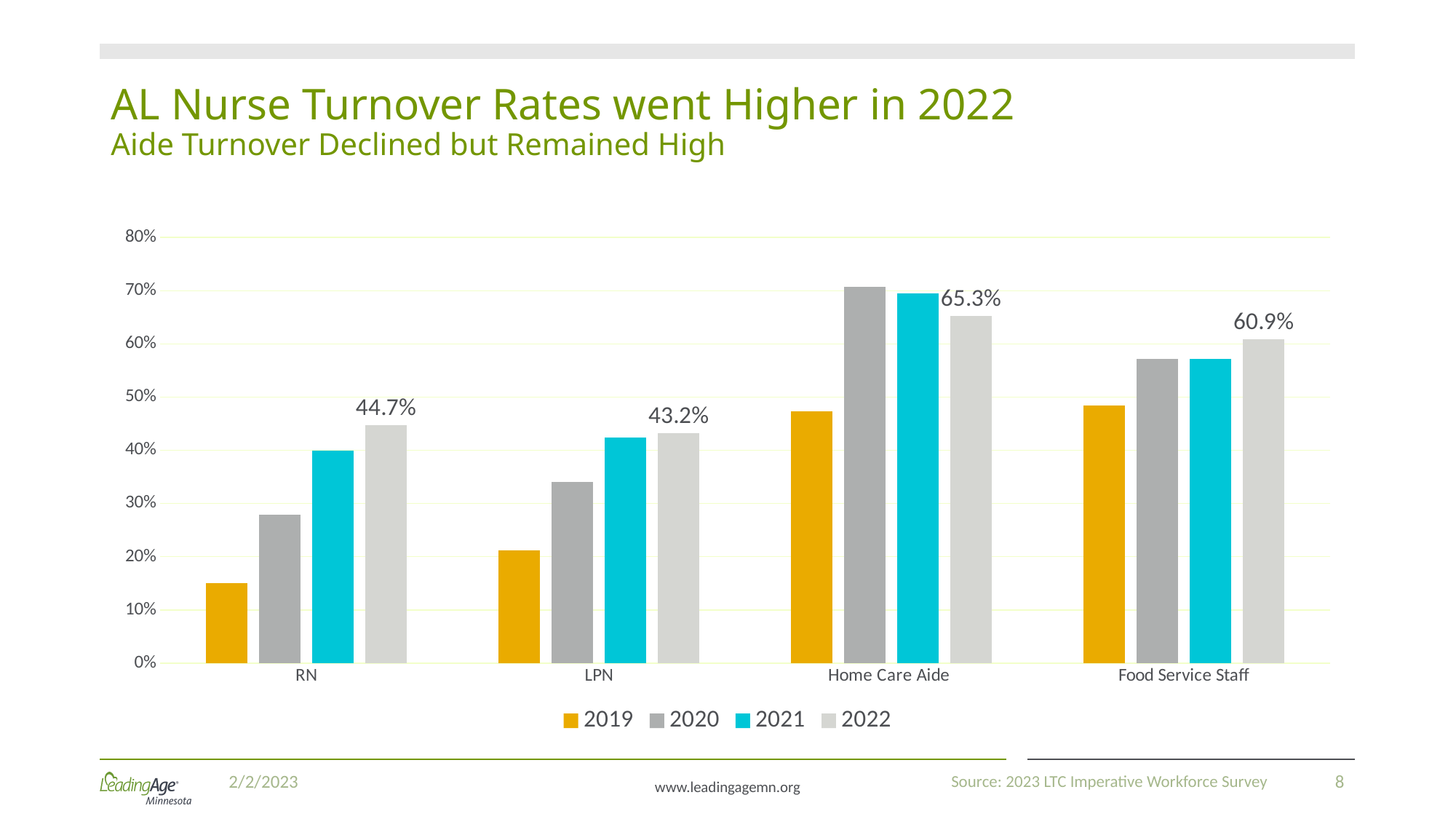
Is the 2020 turnover rate for Home Care Aide greater or less than 60%? greater Which category has the highest 2022 turnover rate? Home Care Aide What is the difference between the 2022 turnover rates for Home Care Aide and Food Service Staff? 4.4% Which category has the lowest 2022 turnover rate? LPN What is the 2022 turnover rate for LPN? 43.2% How many series does the legend list? 4 Is the 2019 turnover rate for RN greater or less than 20%? less What is the 2022 turnover rate for Food Service Staff? 60.9% What is the 2022 turnover rate for Home Care Aide? 65.3% Do the turnover rates for RN rise or fall from 2019 to 2022? Rise What is the 2022 turnover rate for RN? 44.7% What kind of chart is shown on the slide? Bar chart